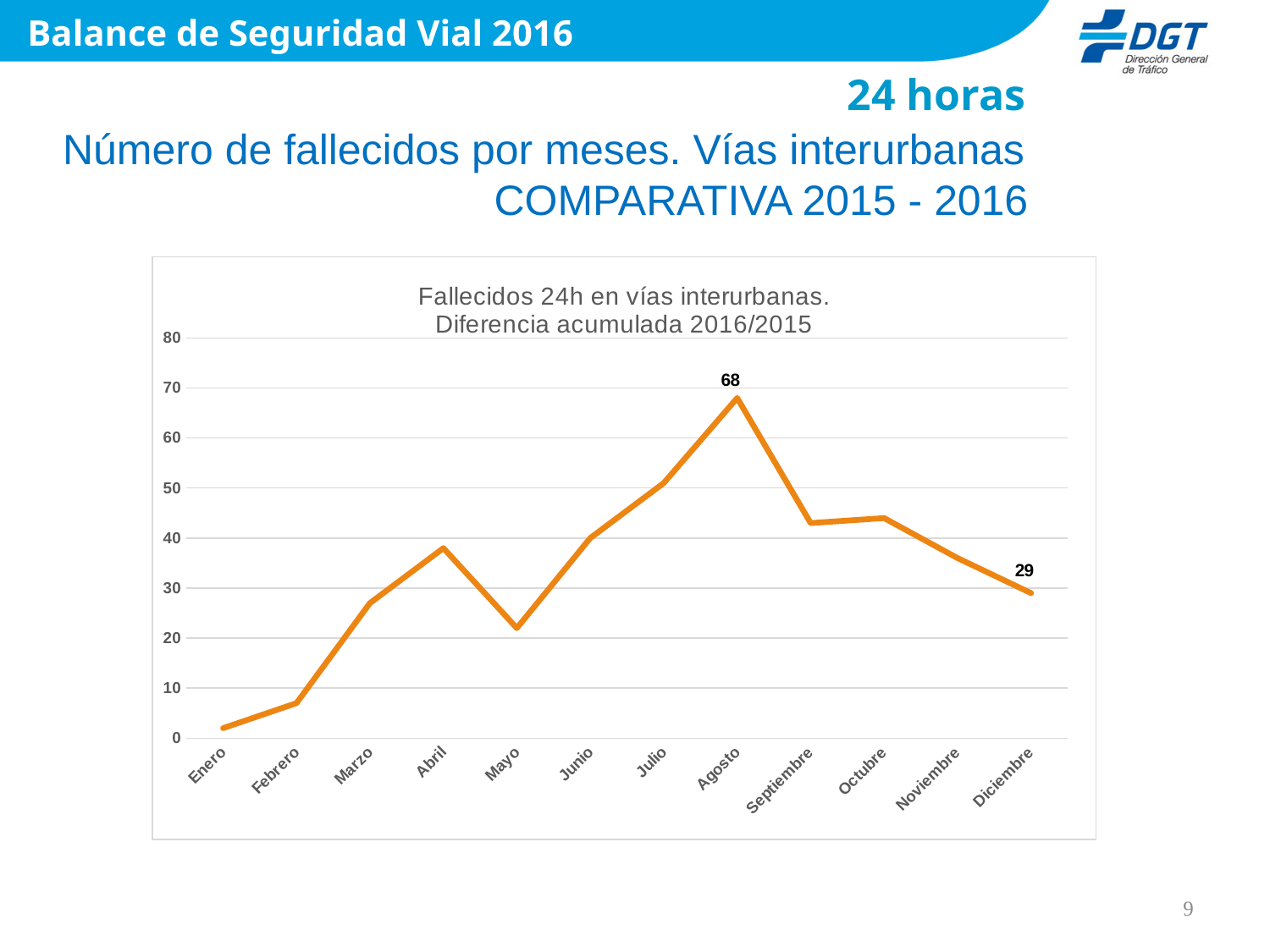
Which month has the highest value? Agosto Is the value for Febrero greater or less than 10? less How many months are plotted on the x axis? 12 Do the values rise or fall from Enero to Abril? rise Which is larger, the value for Agosto or the value for Diciembre? Agosto What type of chart is shown on the slide? line chart What is the value for Diciembre? 29 What is the difference between the values for Agosto and Diciembre? 39 Which month has the lowest value? Enero What is the value for Agosto? 68